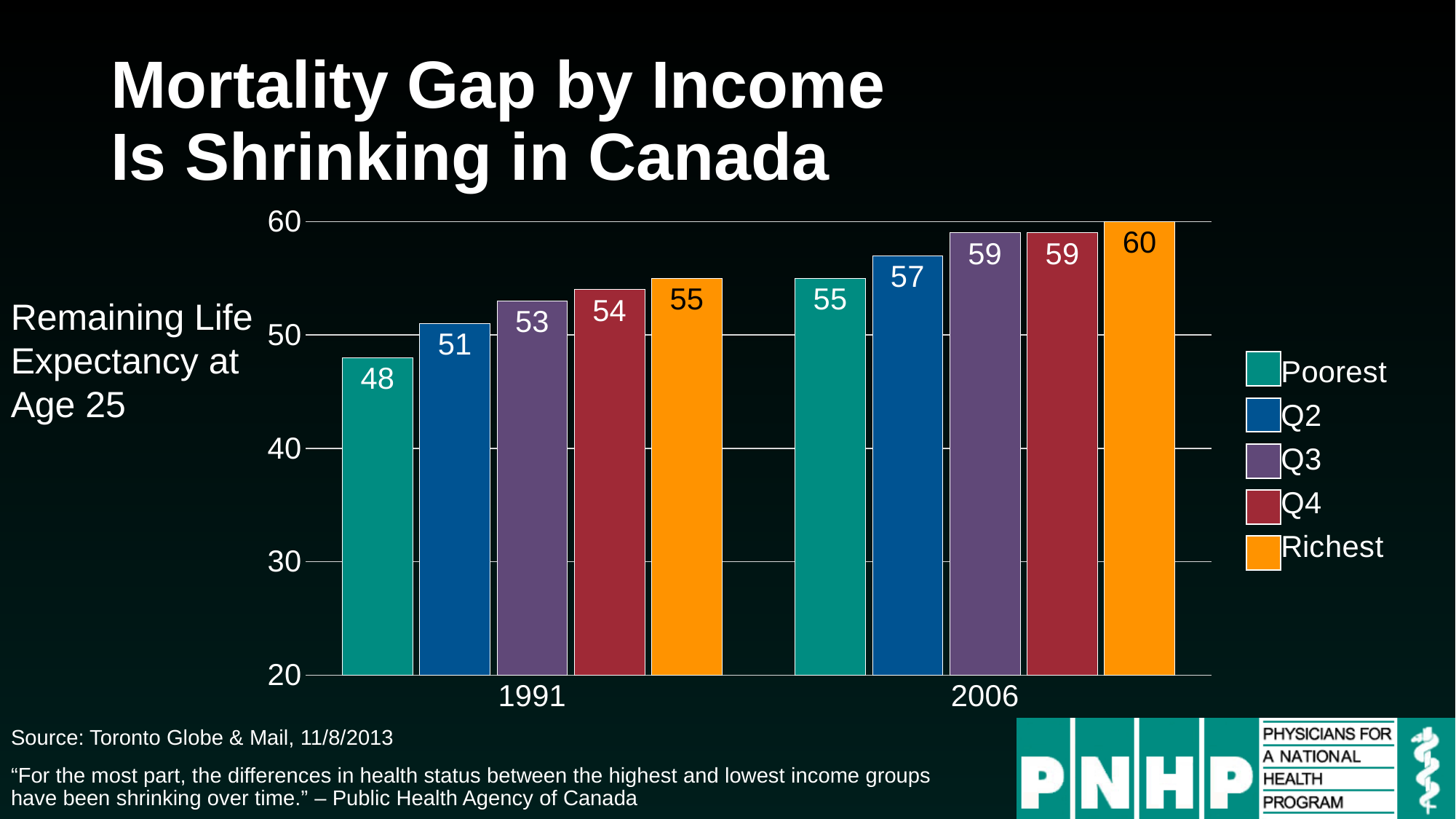
How many series does the legend list? 5 Is the value for the Poorest group in 1991 greater or less than 50? less What is the difference between the Richest and Poorest values in 2006? 5 What is the value for Q2 in 2006? 57 Which income group has the lowest value in 1991? Poorest What is the difference between the Richest and Poorest values in 1991? 7 Which is larger: the Poorest value in 2006 or the Q3 value in 1991? Poorest in 2006 What is the remaining life expectancy at age 25 for the Poorest group in 1991? 48 What is the value for the Richest group in 2006? 60 Which income group has the highest value in 2006? Richest Which colour represents the Richest group in the legend? Orange What kind of chart is shown on the slide? Bar chart